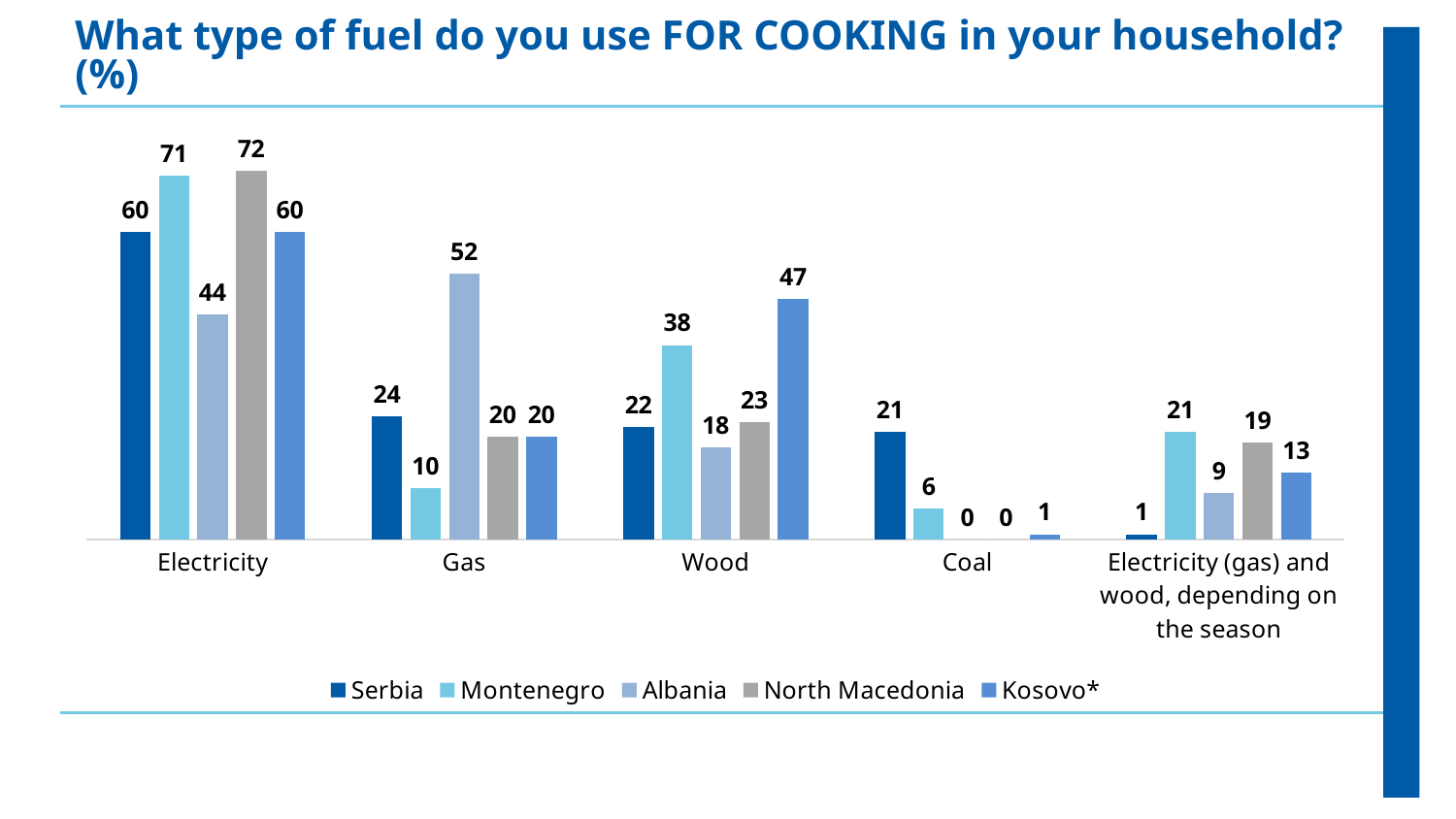
How many fuel categories are shown on the x axis? 5 What is the value for Montenegro in the 'Electricity (gas) and wood, depending on the season' category? 21 What is the value for Kosovo* in the Wood category? 47 What is the value for Serbia in the Coal category? 21 Which country has the highest value in the Electricity category? North Macedonia What kind of chart is shown on the slide? Bar chart Which country has the lowest value in the Electricity category? Albania Which is larger: Serbia's value for Gas or Albania's value for Gas? Albania's value for Gas How many series does the legend list? 5 What is the value for Albania in the Gas category? 52 What is the difference between Montenegro and Serbia in the Wood category? 16 Which series is shown in the darkest blue colour in the legend? Serbia